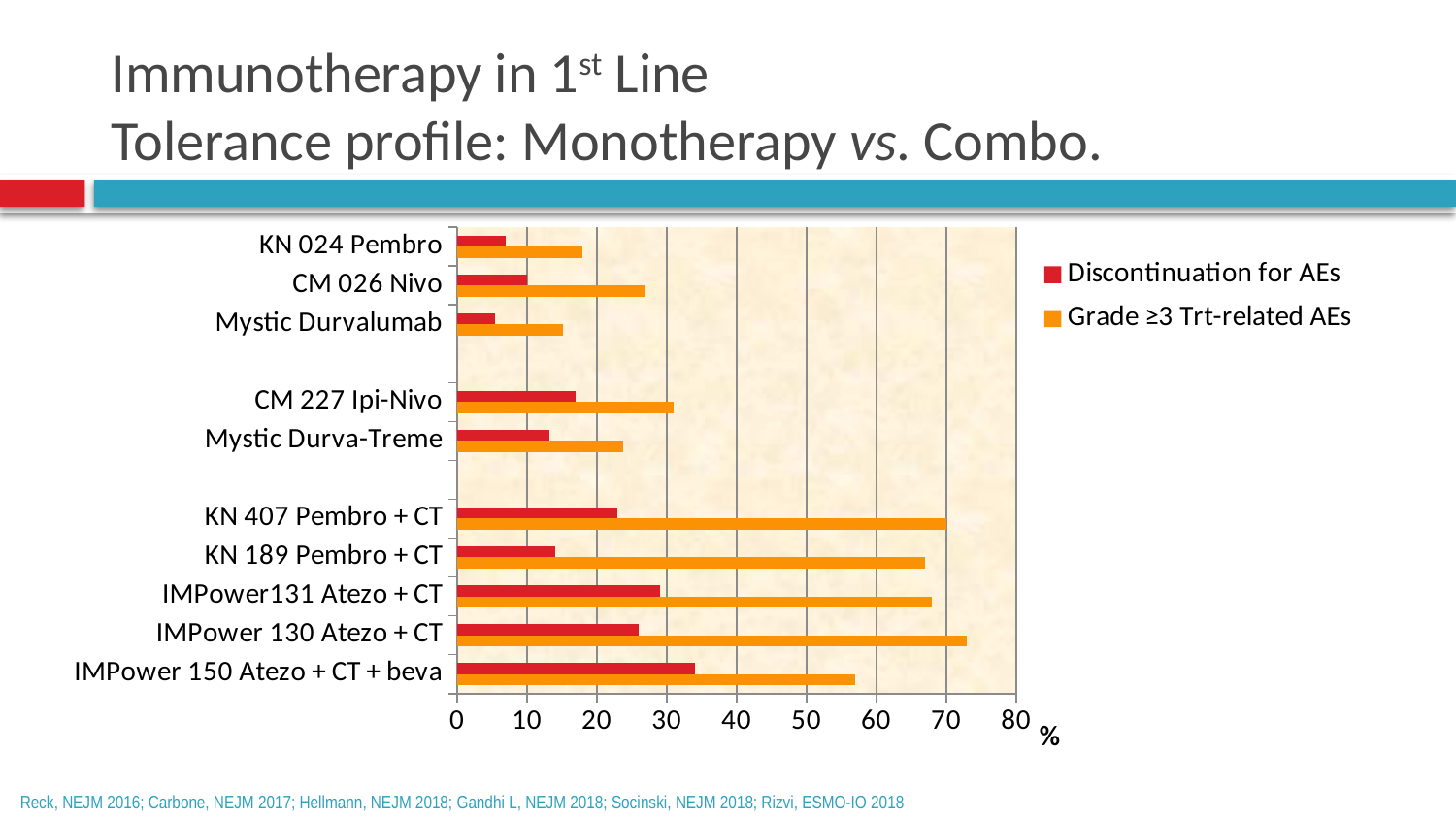
Is the Discontinuation for AEs value for IMPower 150 Atezo + CT + beva greater or less than 30? greater Is the Grade ≥3 Trt-related AEs value for KN 024 Pembro greater or less than 20? less How many trials/regimens are plotted on the chart? 10 Is the Grade ≥3 Trt-related AEs value for KN 407 Pembro + CT greater or less than 60? greater Which has the larger Grade ≥3 Trt-related AEs value, KN 407 Pembro + CT or IMPower 150 Atezo + CT + beva? KN 407 Pembro + CT Which has the larger Discontinuation for AEs value, CM 227 Ipi-Nivo or Mystic Durva-Treme? CM 227 Ipi-Nivo Which colour represents Discontinuation for AEs in the legend? red Which regimen has the highest Discontinuation for AEs value? IMPower 150 Atezo + CT + beva What kind of chart is shown on the slide? bar chart How many series does the legend list? 2 What unit is shown on the horizontal axis? %